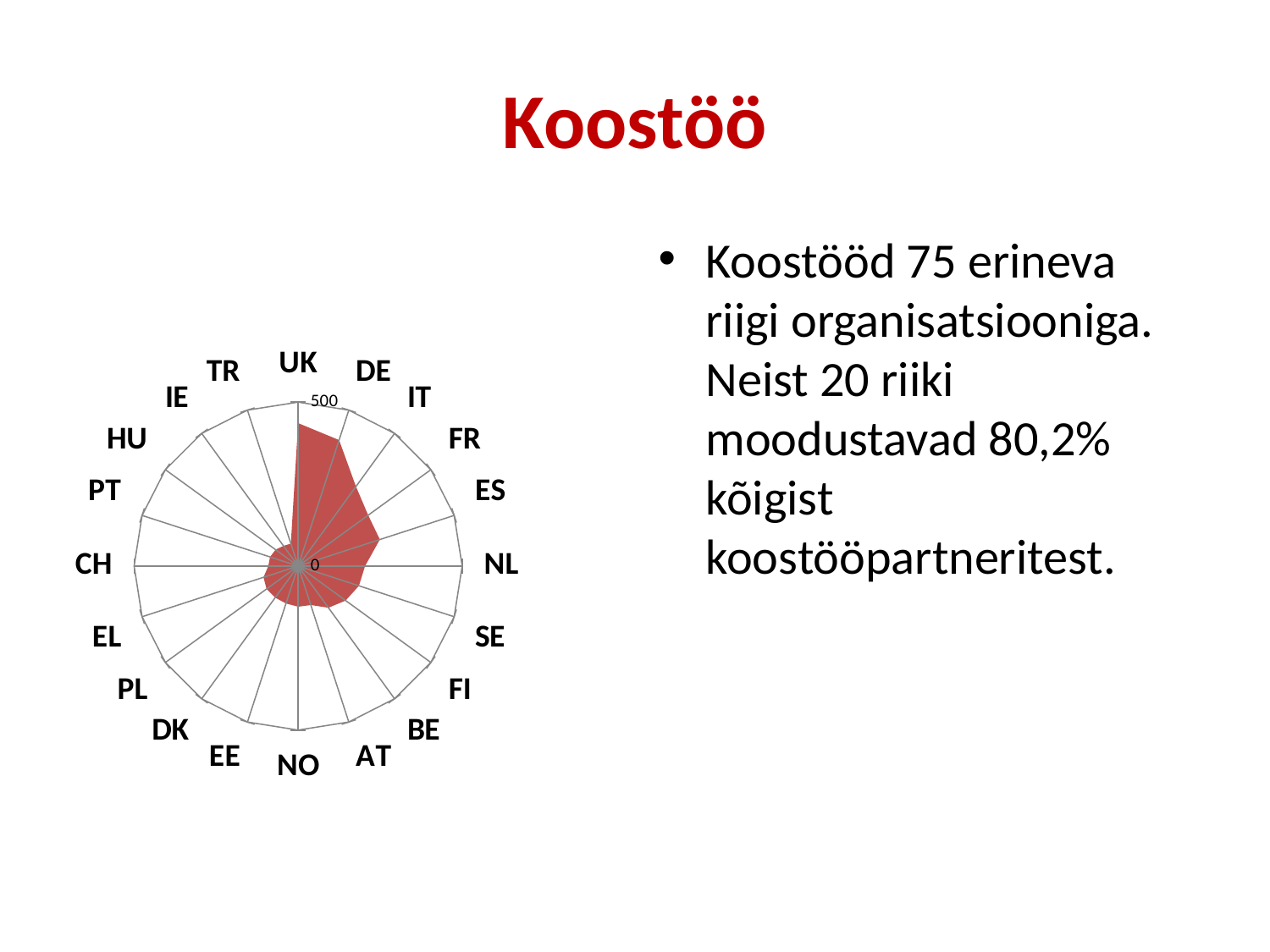
Is the value for UK greater or less than 250? greater What is the maximum value shown on the radar chart's axis? 500 What is the title of the slide containing the radar chart? Koostöö Which has the larger value, IT or PT? IT Is the value for DE greater or less than 250? greater What kind of chart is shown on the slide? radar chart How many categories (country codes) are plotted on the radar chart? 20 Is the value for EE greater or less than 250? less Which has the larger value, DE or CH? DE Which has the larger value, UK or NO? UK